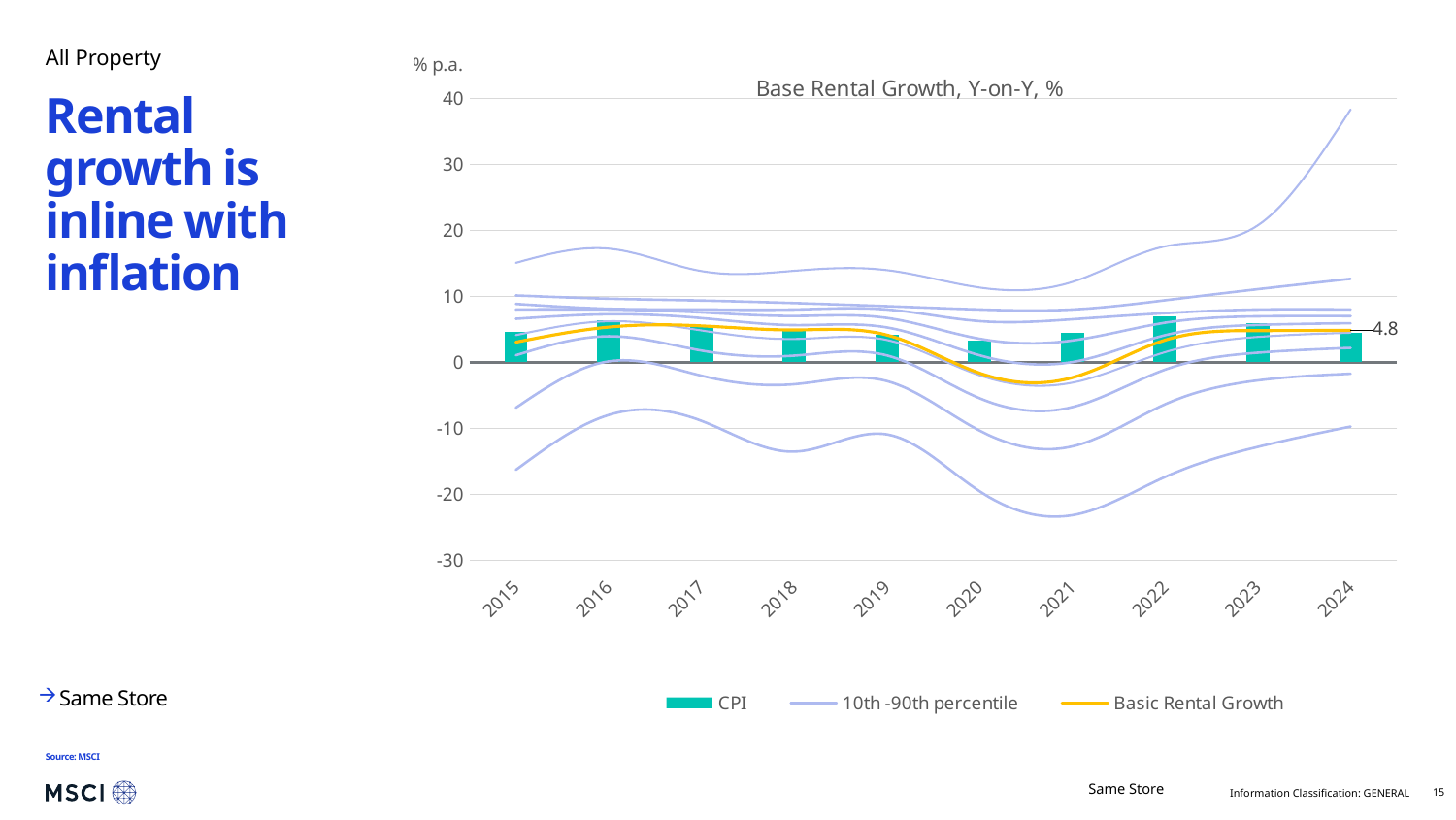
How many years are shown on the x axis? 10 Which year has the highest CPI bar? 2022 What is the title of the chart? Base Rental Growth, Y-on-Y, % Which is larger, the CPI bar for 2022 or the CPI bar for 2020? 2022 Is the Basic Rental Growth value in 2021 greater or less than 0? less Is the CPI value for 2022 greater or less than 5? greater What is the labelled value of Basic Rental Growth in 2024? 4.8 Does the Basic Rental Growth line rise or fall between 2019 and 2021? fall What kind of chart is this? Combined bar and line chart What unit label is shown at the top of the y axis? % p.a. Is the CPI value for 2020 greater or less than 5? less How many series does the legend list? 3